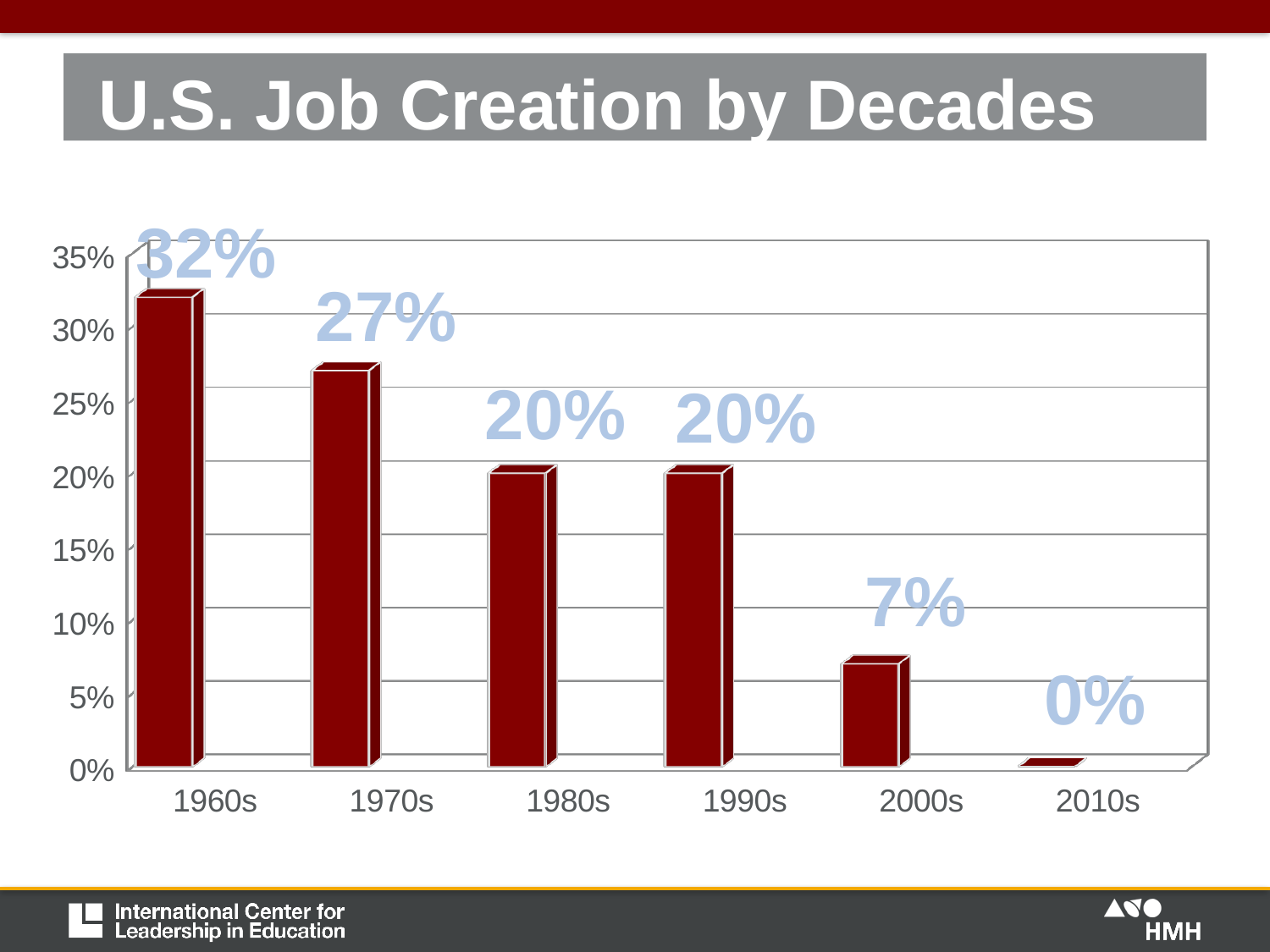
Which decade has the lowest value? 2010s What is the value for the 2010s? 0% Which is larger, the value for the 1970s or the value for the 1980s? 1970s What is the value for the 1970s? 27% What kind of chart is this? bar chart Which decade has the highest value? 1960s What is the value for the 2000s? 7% What is the difference between the values for the 1960s and the 1970s? 5% Do the values rise or fall from the 1960s to the 2010s? fall What is the difference between the values for the 1990s and the 2000s? 13% What is the value for the 1960s? 32% How many decades are shown on the x axis? 6